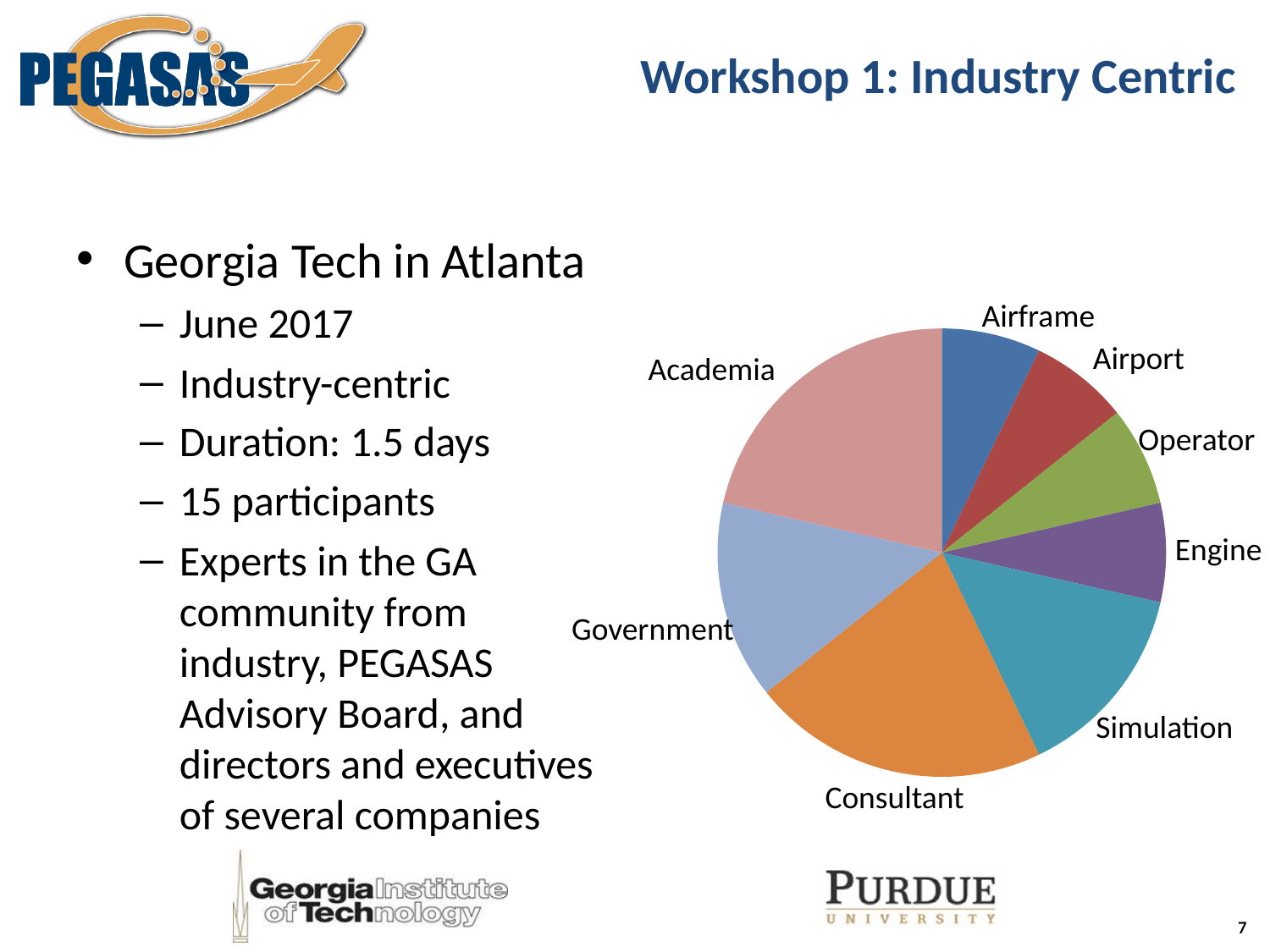
Which slice is larger in the pie chart, Engine or Consultant? Consultant Which slice is larger in the pie chart, Academia or Engine? Academia How many categories (slices) does the pie chart have? 8 Which slice is larger in the pie chart, Government or Airport? Government What colour is the Consultant slice in the pie chart? orange What kind of chart is shown on the slide? pie chart What is the title of the slide containing the pie chart? Workshop 1: Industry Centric